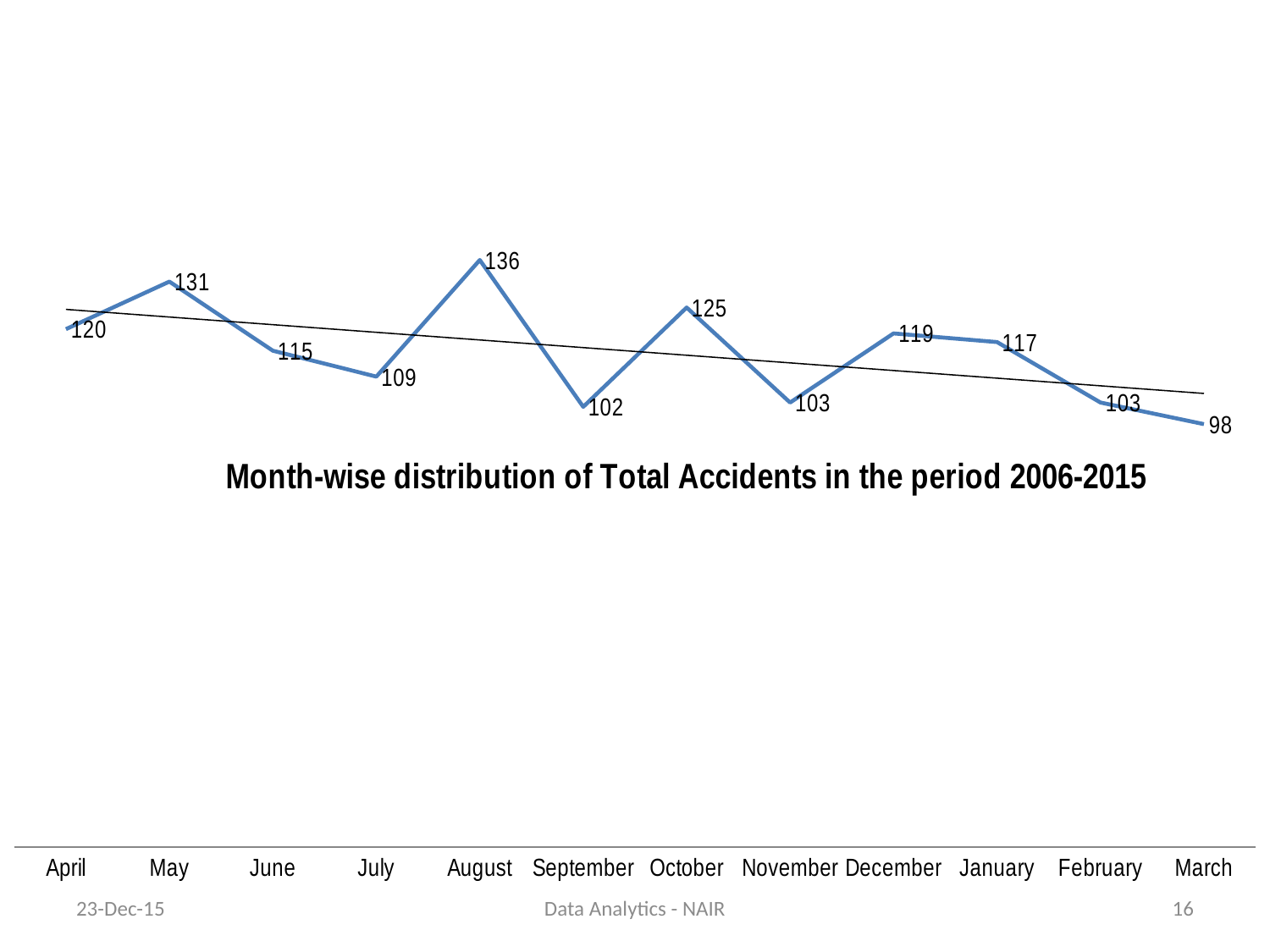
What is the difference between the values for May and June? 16 How many months are plotted on the chart? 12 Which is larger, the value for October or the value for January? October Which month has the lowest value? March What is the value for August? 136 What kind of chart is shown? Line chart Which month has the highest value? August What is the difference between the values for August and September? 34 What is the value for December? 119 What is the value for March? 98 Does the trend line on the chart rise or fall from April to March? Fall What is the title of the chart? Month-wise distribution of Total Accidents in the period 2006-2015